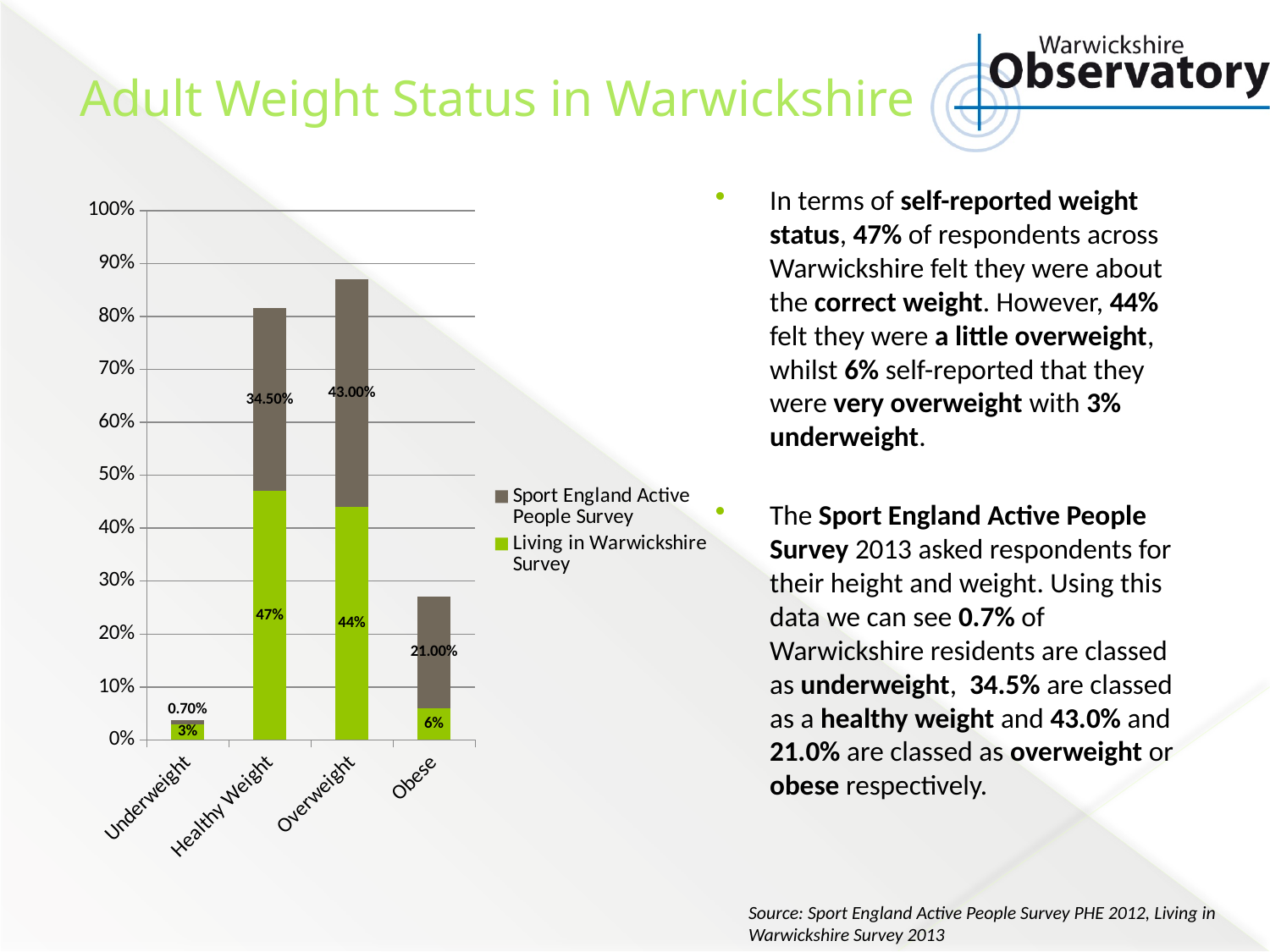
How many series does the chart legend list? 2 Which category has the lowest Living in Warwickshire Survey value? Underweight How many weight categories are shown on the x axis? 4 Which category has the highest Sport England Active People Survey value? Overweight What is the Sport England Active People Survey value for Healthy Weight? 34.50% Which is larger for Obese: the Sport England Active People Survey value or the Living in Warwickshire Survey value? Sport England Active People Survey What is the difference between the Sport England Active People Survey values for Overweight and Obese? 22.00% What is the Sport England Active People Survey value for Underweight? 0.70% What kind of chart is shown on the slide? Stacked bar chart What is the Living in Warwickshire Survey value for Obese? 6% What is the total height of the stacked bar for Healthy Weight? 81.50% Which series is shown in green in the chart? Living in Warwickshire Survey